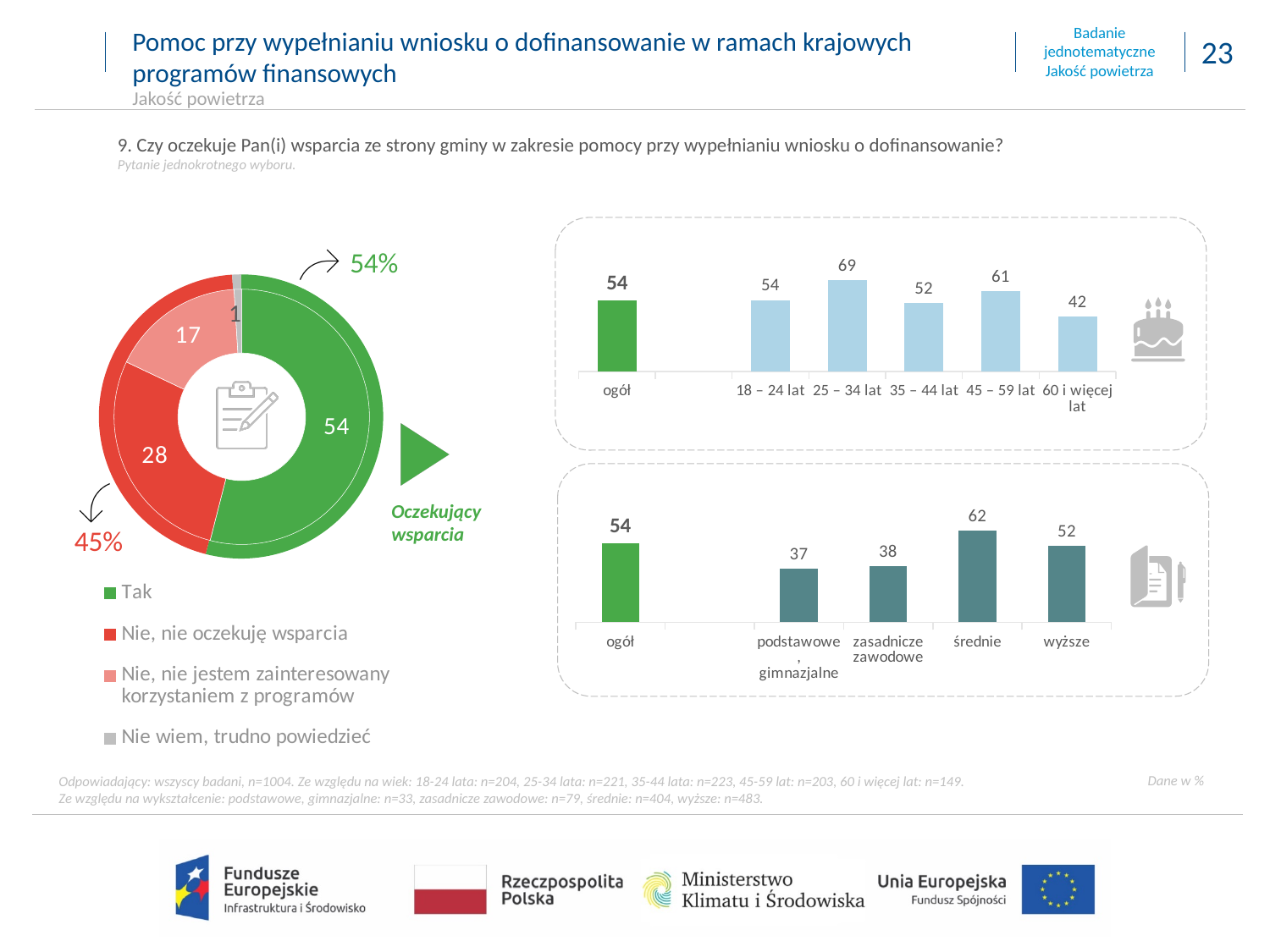
In the top-right bar chart by age, what is the difference between the values for "25 – 34 lat" and "60 i więcej lat"? 27 In the top-right bar chart by age, what is the value for "25 – 34 lat"? 69 In the bottom-right bar chart by education, which is larger: the value for "wyższe" or the value for "podstawowe, gimnazjalne"? wyższe In the top-right bar chart by age, how many bars are plotted? 6 In the bottom-right bar chart by education, which category has the highest value? średnie In the donut chart on the left, what is the value for "Tak"? 54 In the top-right bar chart by age, which age group has the lowest value? 60 i więcej lat In the donut chart on the left, which category has the smallest value? Nie wiem, trudno powiedzieć What type of chart is the bottom-right chart by education? Bar chart In the donut chart on the left, what is the value for "Nie, nie oczekuję wsparcia"? 28 In the donut chart on the left, how many entries does the legend list? 4 In the bottom-right bar chart by education, what is the value for "średnie"? 62